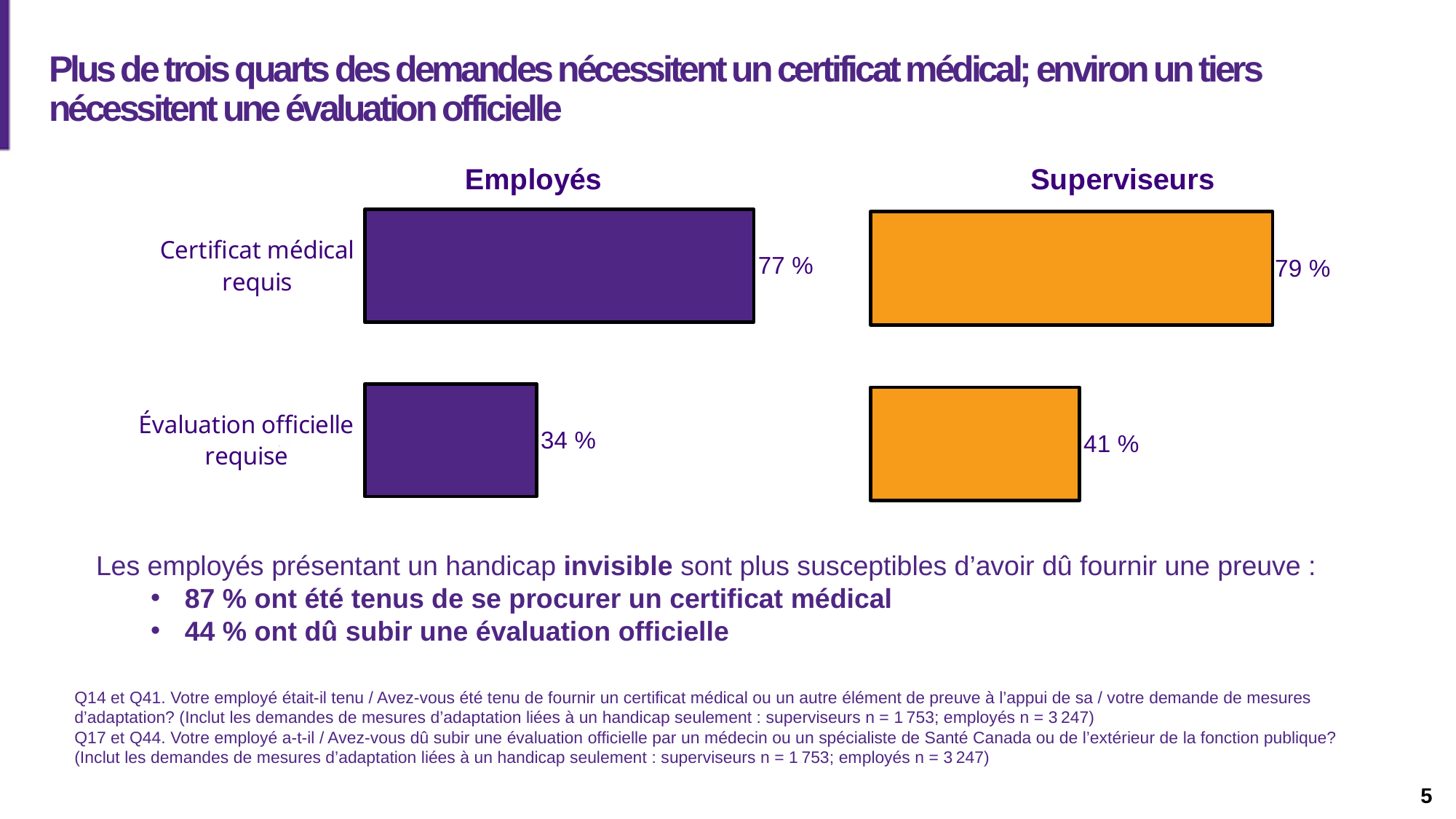
In the Superviseurs chart, which category has the lowest value? Évaluation officielle requise In the Employés chart, what is the value for Évaluation officielle requise? 34 % How many categories does the Employés chart show? 2 In the Employés chart, what is the value for Certificat médical requis? 77 % In the Employés chart, what is the difference between Certificat médical requis and Évaluation officielle requise? 43 % In the Superviseurs chart, what is the value for Certificat médical requis? 79 % In the Employés chart, which category has the highest value? Certificat médical requis What kind of chart is the Superviseurs chart? Bar chart Is the value for Évaluation officielle requise larger in the Employés chart or the Superviseurs chart? Superviseurs What colour are the bars in the Superviseurs chart? Orange In the Superviseurs chart, what is the value for Évaluation officielle requise? 41 % In the Superviseurs chart, what is the difference between Certificat médical requis and Évaluation officielle requise? 38 %